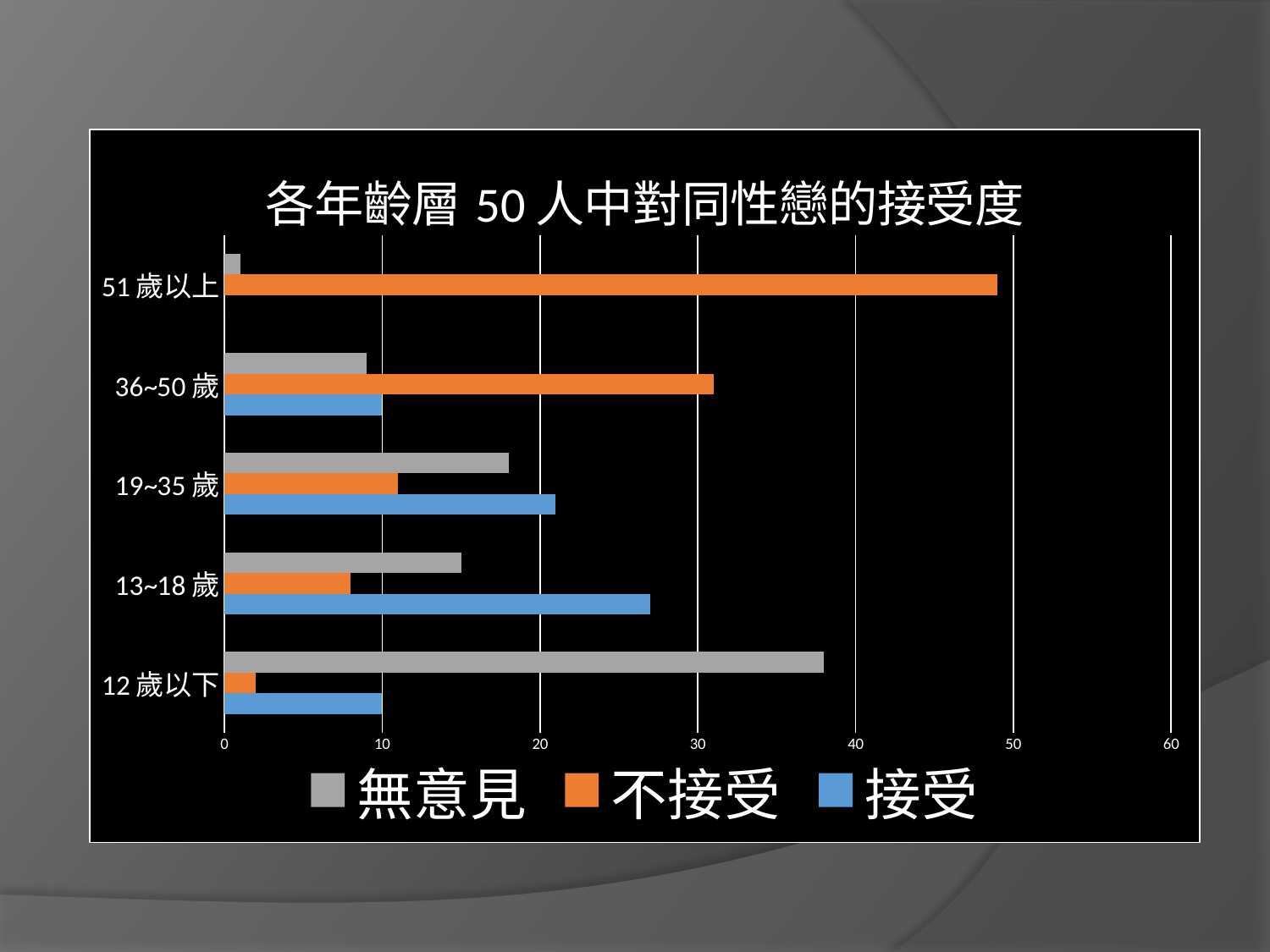
How many age groups are shown on the chart? 5 What kind of chart is shown on the slide? bar chart Which age group has the highest 無意見 value? 12 歲以下 What is the 接受 value for 36~50 歲? 10 Which age group has the lowest 不接受 value? 12 歲以下 What is the 接受 value for 12 歲以下? 10 How many series does the legend list? 3 Which age group has the highest 不接受 value? 51 歲以上 What is the title of the chart? 各年齡層 50 人中對同性戀的接受度 Is the 無意見 value for 19~35 歲 greater or less than 20? less Which is larger: the 接受 value for 13~18 歲 or for 19~35 歲? 13~18 歲 Is the 不接受 value for 51 歲以上 greater or less than 40? greater